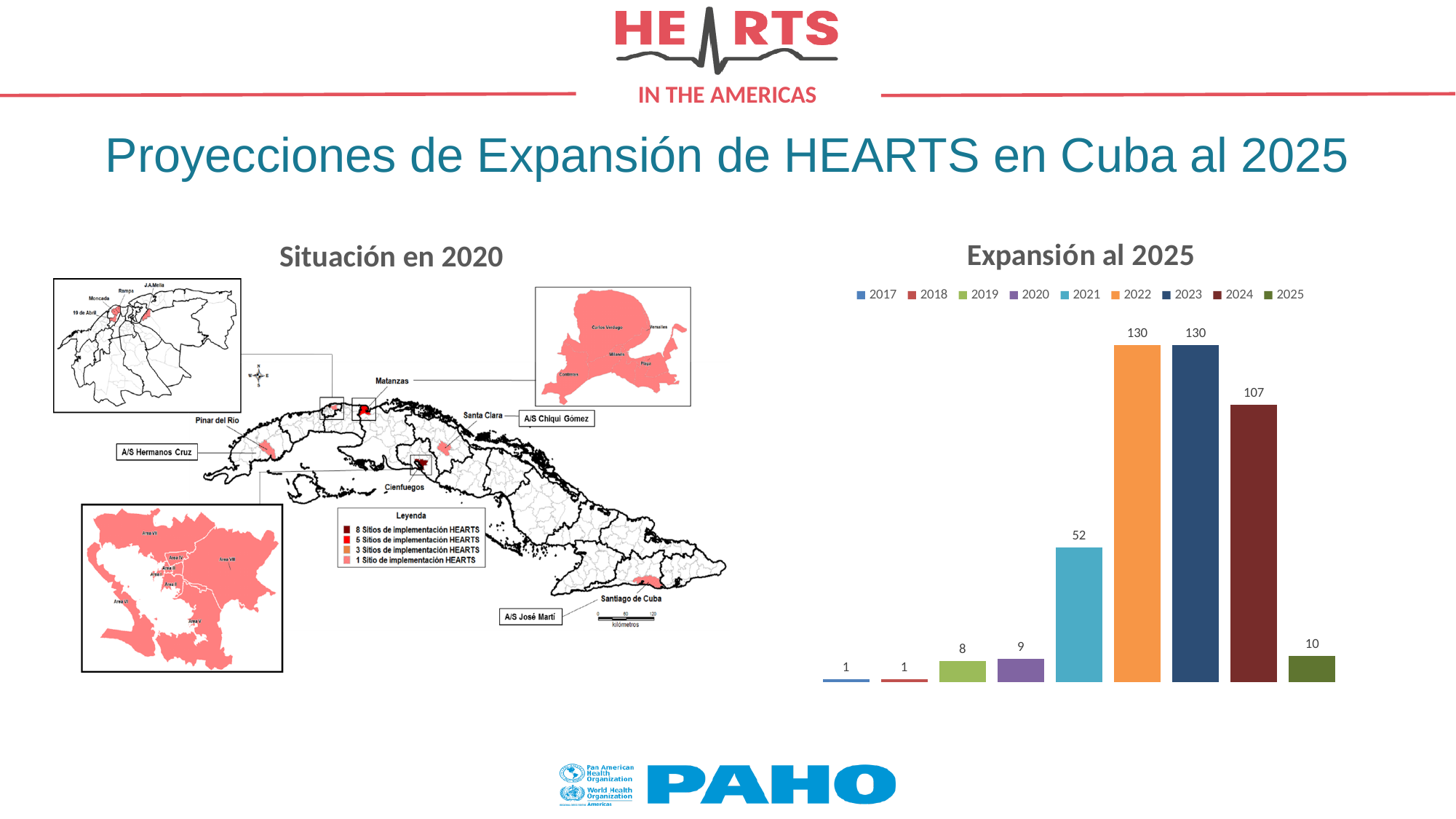
In the 'Expansión al 2025' chart, what is the value for 2019? 8 In the 'Expansión al 2025' chart, what is the highest value shown on any bar? 130 In the 'Expansión al 2025' chart, what is the value for 2025? 10 In the 'Expansión al 2025' chart, what is the value for 2024? 107 In the 'Expansión al 2025' chart, what is the difference between the values for 2022 and 2024? 23 In the 'Expansión al 2025' chart, which has a larger value, 2021 or 2024? 2024 What kind of chart is 'Expansión al 2025'? Bar chart How many bars are plotted in the 'Expansión al 2025' chart? 9 How many entries does the legend of the 'Expansión al 2025' chart list? 9 In the 'Expansión al 2025' chart, which has a larger value, 2020 or 2025? 2025 In the 'Expansión al 2025' chart, what is the difference between the values for 2021 and 2020? 43 In the 'Expansión al 2025' chart, what is the value for 2021? 52